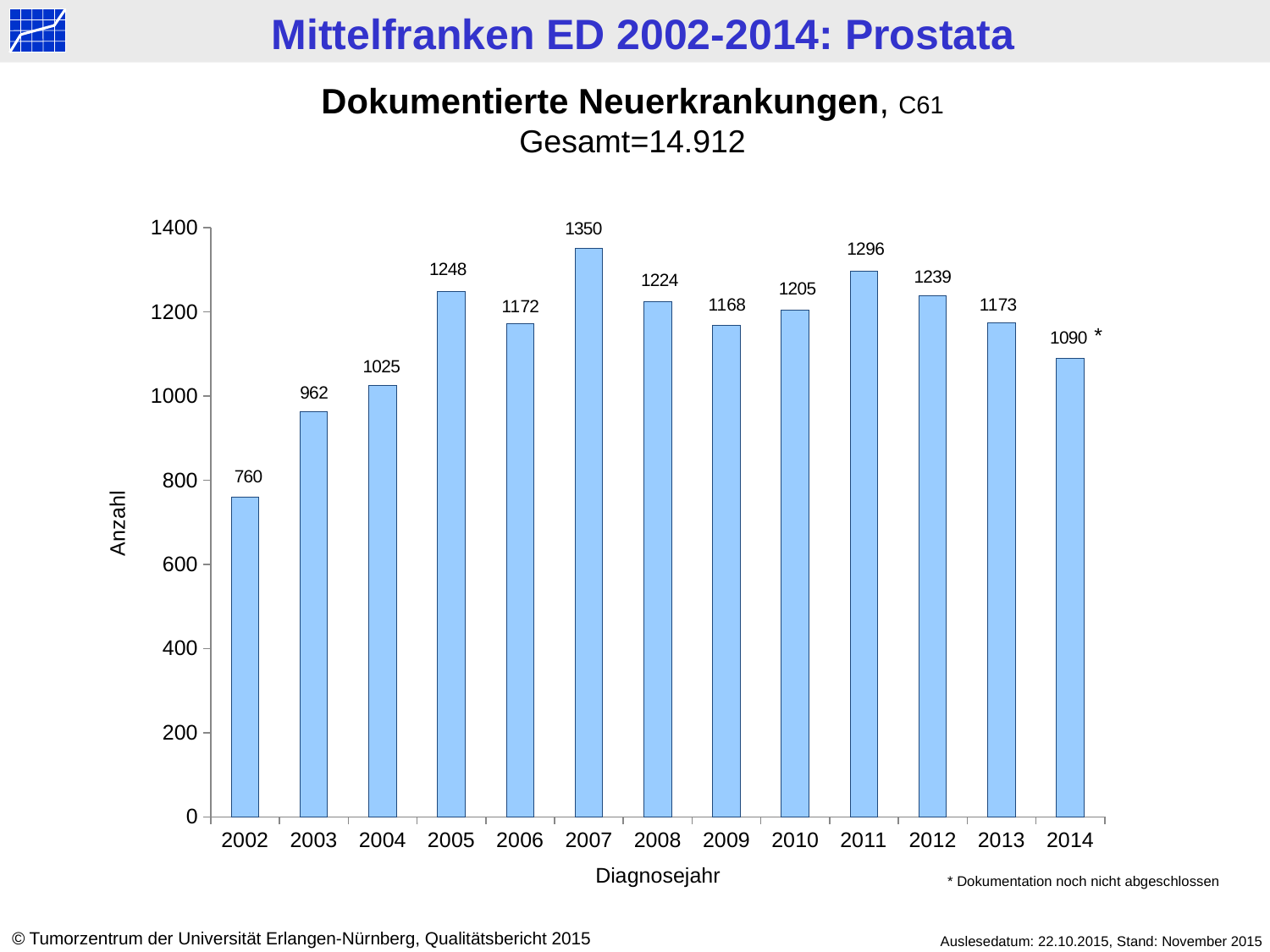
Is the value for 2003 greater or less than 1000? less Which year has the highest value? 2007 How many years are shown on the x axis? 13 What is the label of the y axis? Anzahl What is the value for 2014? 1090 What is the difference between the values for 2005 and 2004? 223 Which is larger, the value for 2008 or the value for 2010? 2008 What is the difference between the values for 2007 and 2002? 590 Which year has the lowest value? 2002 What is the value for 2002? 760 What is the value for 2011? 1296 What kind of chart is this? bar chart